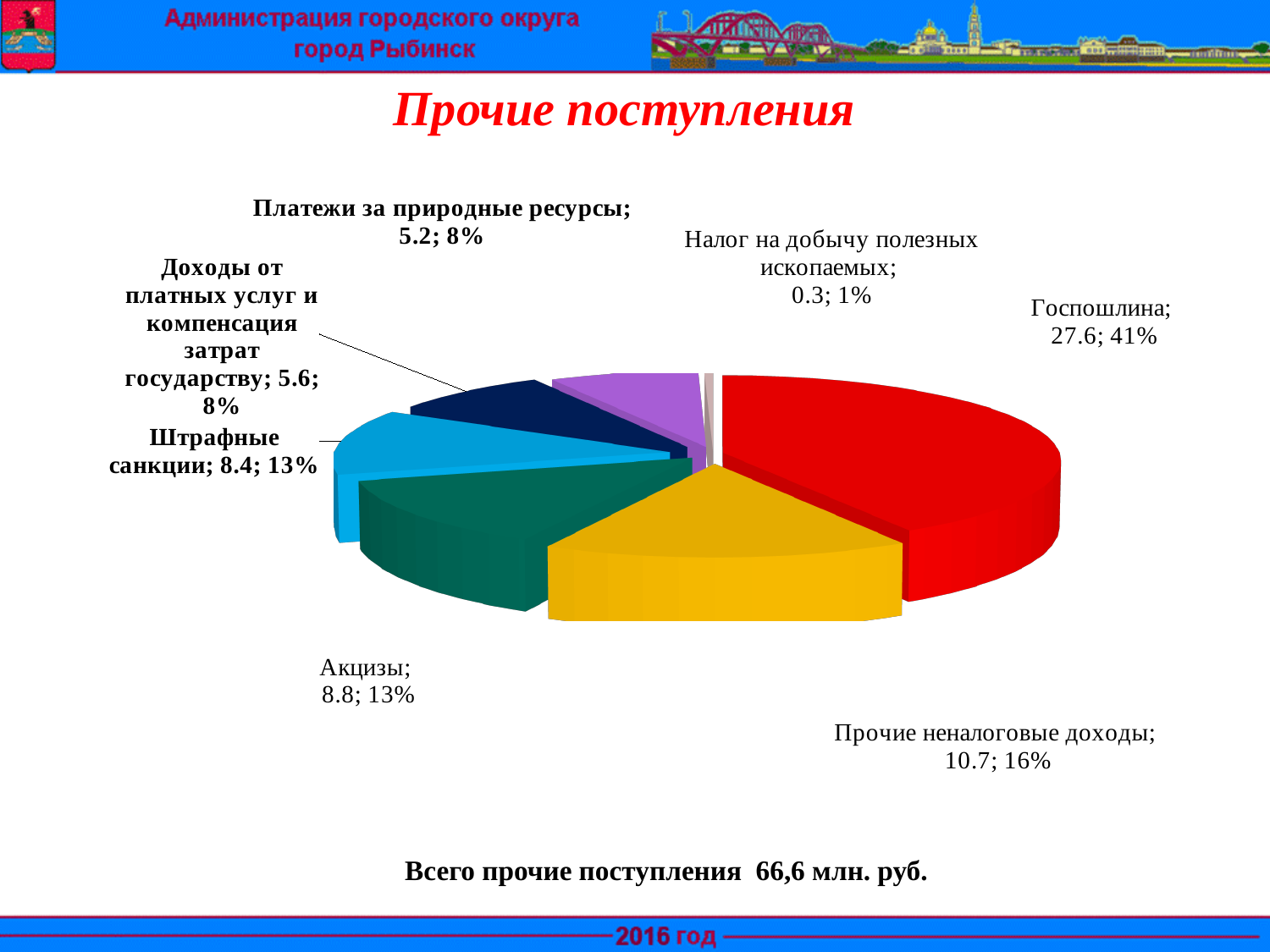
What is the title of the chart? Прочие поступления Which category has the largest slice? Госпошлина What is the value for Прочие неналоговые доходы? 10.7 What is the value for Госпошлина? 27.6 What share of the pie does Акцизы take? 13% What is the value for Платежи за природные ресурсы? 5.2 Which category has the smallest slice? Налог на добычу полезных ископаемых What share of the pie does Госпошлина take? 41% What kind of chart is shown on the slide? Pie chart What is the difference between the values for Госпошлина and Прочие неналоговые доходы? 16.9 Which is larger, the value for Акцизы or the value for Штрафные санкции? Акцизы How many slices does the pie chart have? 7